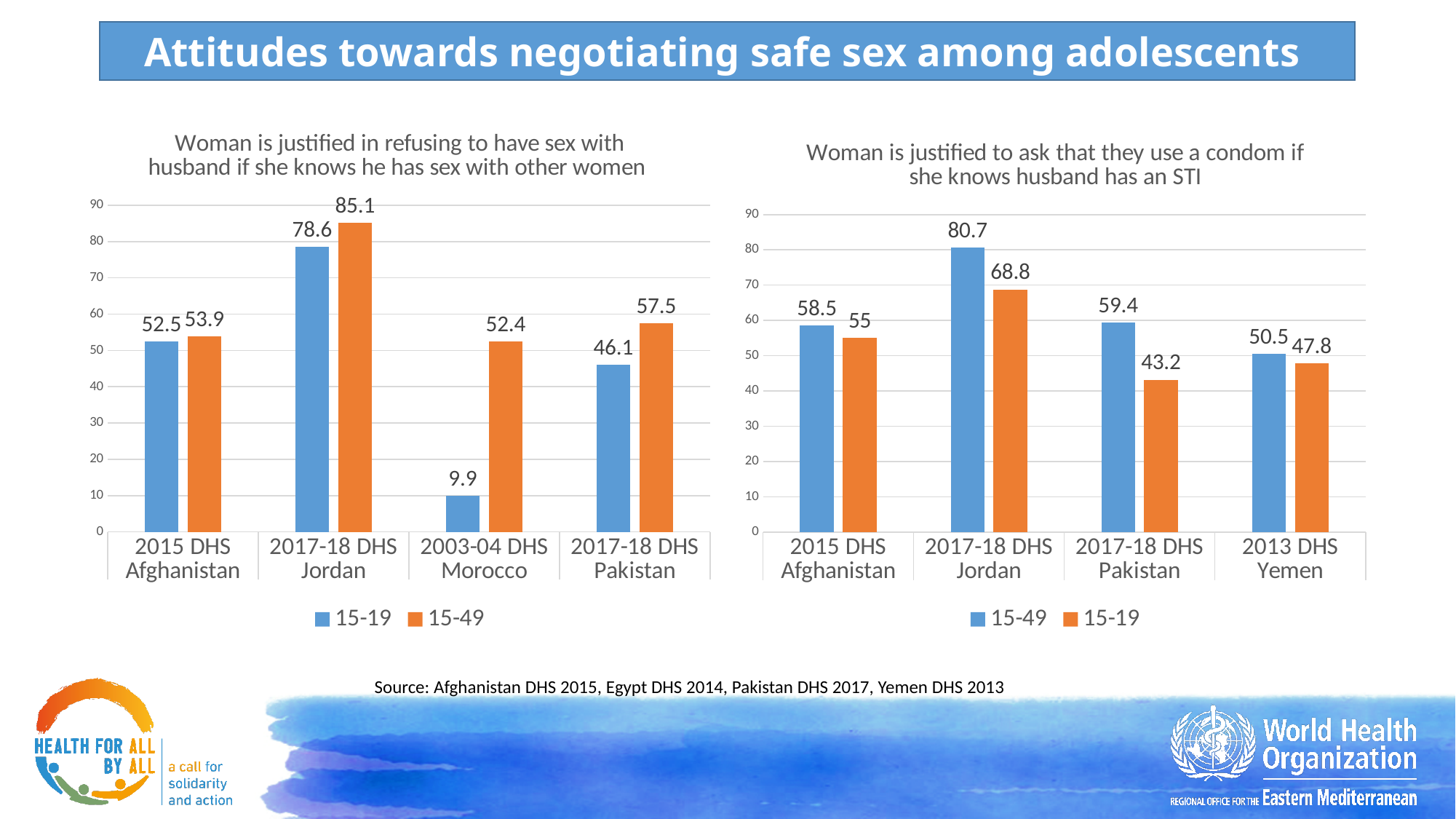
In the right chart (asking to use a condom), what is the value for the 15-49 series for 2013 DHS Yemen? 50.5 In the left chart (refusing sex with husband), which category has the lowest value for the 15-19 series? 2003-04 DHS Morocco In the right chart (asking to use a condom), what is the value for the 15-19 series for 2017-18 DHS Pakistan? 43.2 In the left chart (refusing sex with husband), what is the value for the 15-19 series for 2003-04 DHS Morocco? 9.9 How many series does the legend of the left chart (refusing sex with husband) list? 2 In the left chart (refusing sex with husband), what is the difference between the 15-49 and 15-19 values for 2003-04 DHS Morocco? 42.5 In the right chart (asking to use a condom), what is the difference between the 15-49 and 15-19 values for 2017-18 DHS Jordan? 11.9 In the right chart (asking to use a condom), which is larger for 2015 DHS Afghanistan: the 15-49 value or the 15-19 value? 15-49 In the right chart (asking to use a condom), which category has the highest value for the 15-49 series? 2017-18 DHS Jordan In the left chart (refusing sex with husband), what is the value for the 15-49 series for 2017-18 DHS Jordan? 85.1 What type of chart is the left chart (refusing sex with husband)? Bar chart How many categories are shown on the x axis of the right chart (asking to use a condom)? 4